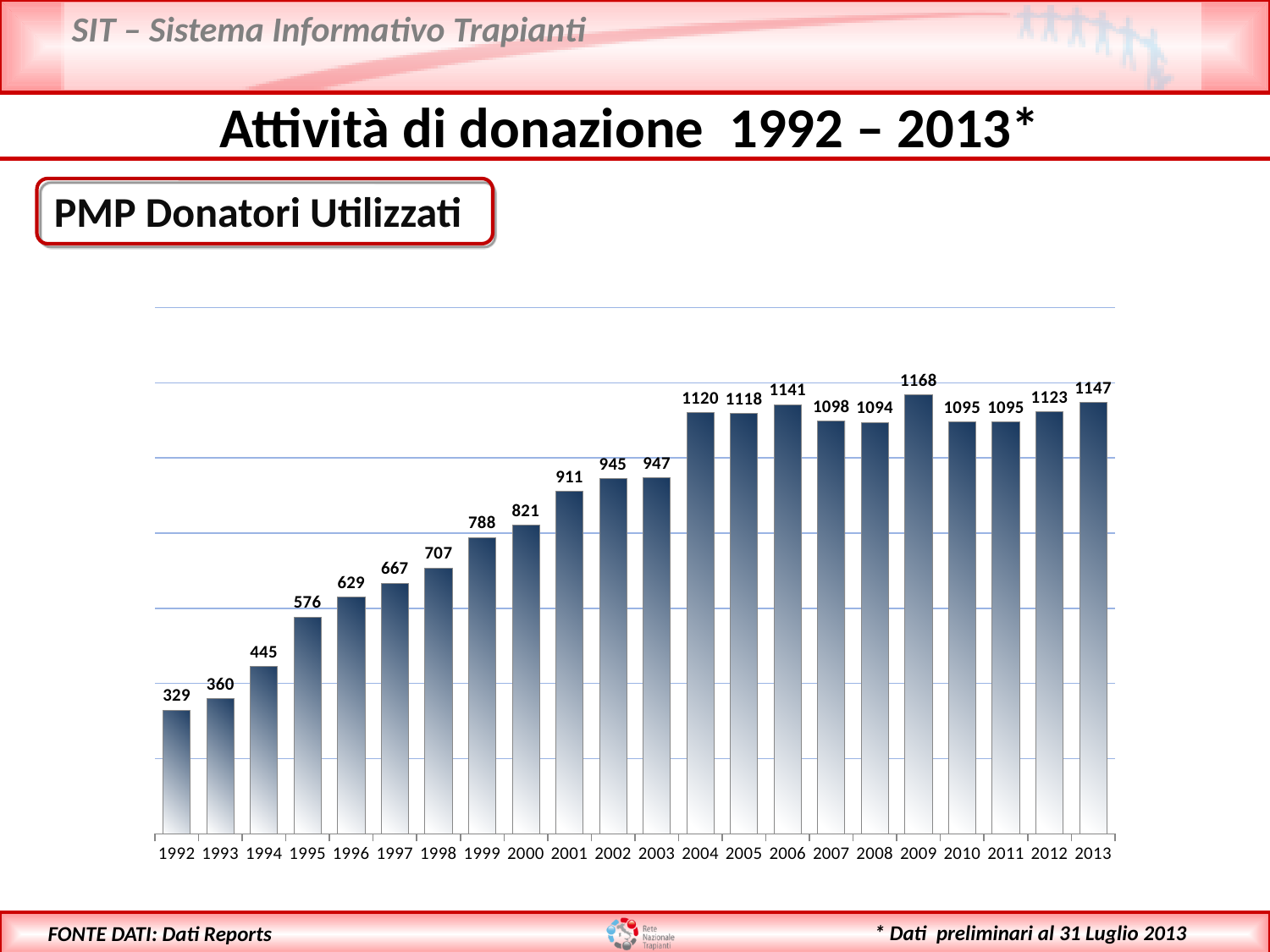
What kind of chart is shown? Bar chart Which is larger, the value for 2006 or the value for 2007? 2006 What is the difference between the values for 2009 and 2008? 74 Which year has the highest value? 2009 What is the difference between the values for 2013 and 1992? 818 What is the value for 2013? 1147 What is the value for 2001? 911 Which year has the lowest value? 1992 What is the value for 2009? 1168 What is the value for 1992? 329 How many years are shown on the x axis? 22 Do the values generally rise or fall from 1992 to 2004? Rise